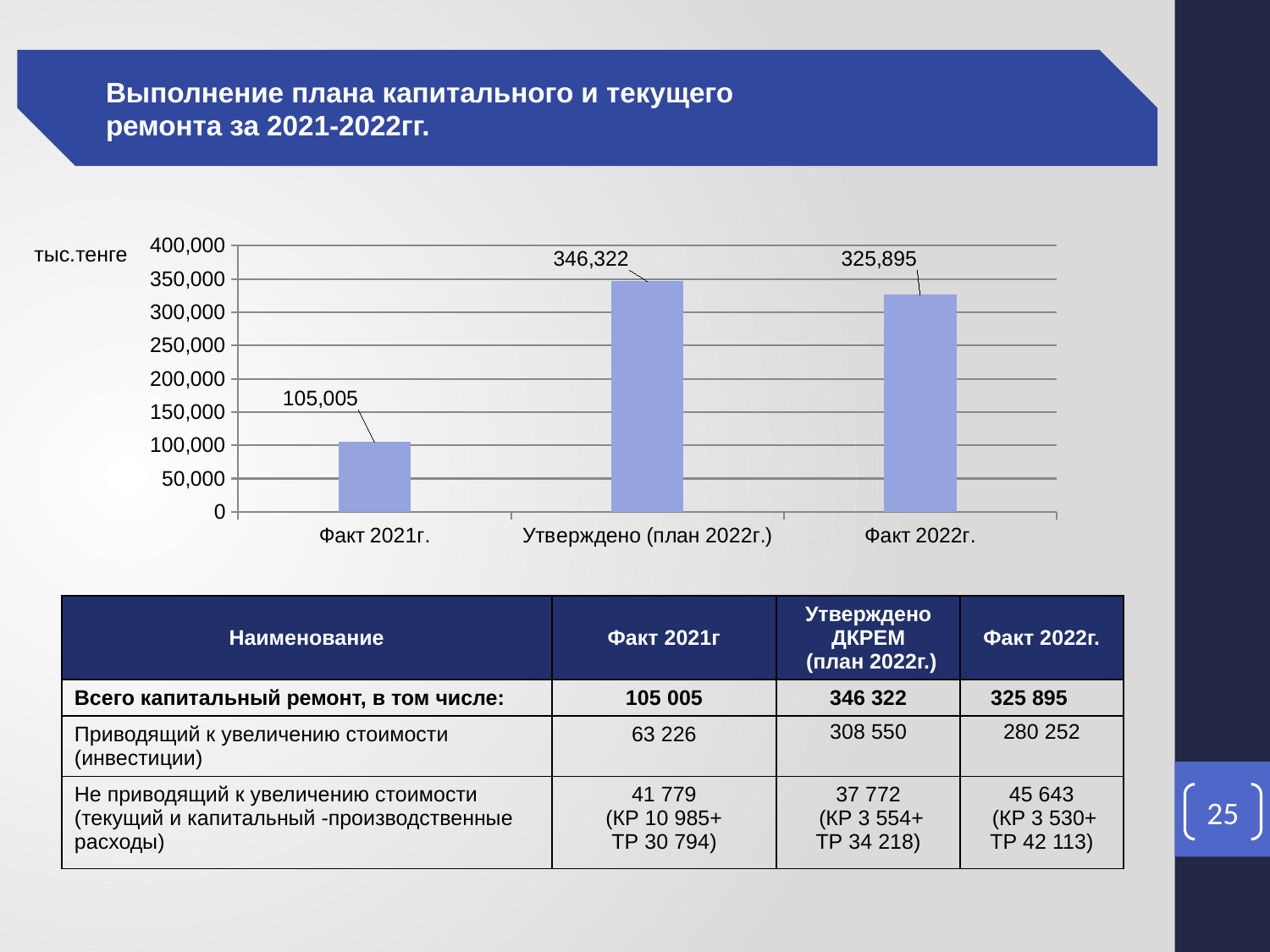
Which category has the lowest value on the chart? Факт 2021г. What unit is indicated next to the chart's vertical axis? тыс.тенге Which category has the highest value on the chart? Утверждено (план 2022г.) What is the value for Факт 2022г. on the chart? 325,895 What is the value for Факт 2021г. on the chart? 105,005 Which is larger, the value for Факт 2021г. or the value for Факт 2022г.? Факт 2022г. How many categories are shown on the chart? 3 What kind of chart is shown on the slide? bar chart What is the difference between the values for Факт 2022г. and Факт 2021г.? 220,890 Is the value for Факт 2021г. greater or less than 150,000? less What is the difference between the values for Утверждено (план 2022г.) and Факт 2022г.? 20,427 What is the value for Утверждено (план 2022г.) on the chart? 346,322